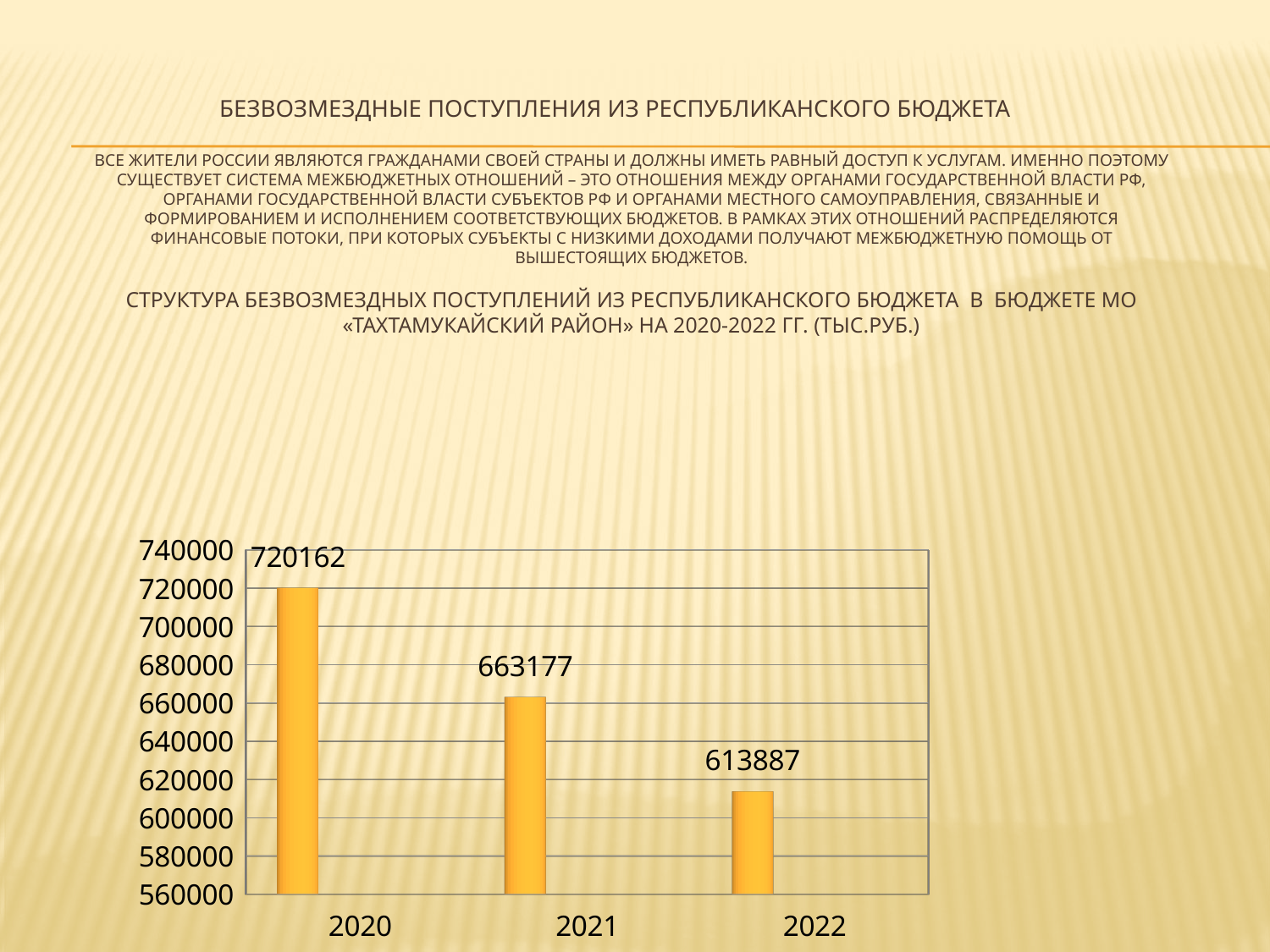
Is the value for 2022 greater or less than 620000? less What kind of chart is shown on the slide? bar chart What is the value for 2022? 613887 What is the value for 2020? 720162 What is the difference between the values for 2021 and 2022? 49290 Which year has the lowest value? 2022 What is the value for 2021? 663177 How many years are shown on the x axis? 3 Do the values rise or fall from 2020 to 2022? fall What is the difference between the values for 2020 and 2021? 56985 Which year has the highest value? 2020 Which is larger, the value for 2021 or the value for 2022? 2021